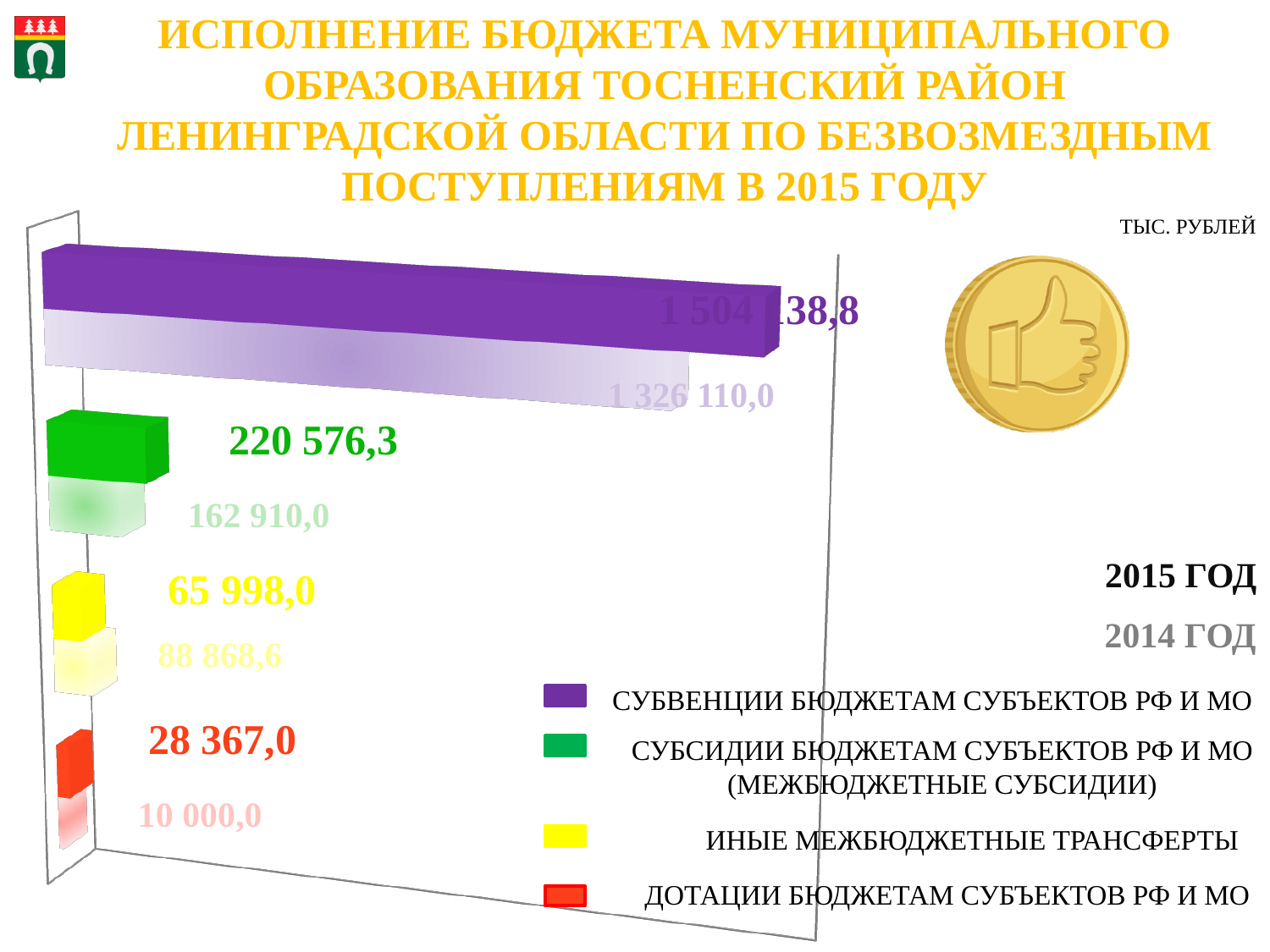
What type of chart is shown on the slide? Bar chart What was the value of иные межбюджетные трансферты in 2015? 65 998,0 What was the value of субвенции бюджетам субъектов РФ и МО in 2014? 1 326 110,0 What was the value of субсидии бюджетам субъектов РФ и МО (межбюджетные субсидии) in 2015? 220 576,3 Which category had the highest value in 2015? Субвенции бюджетам субъектов РФ и МО What was the value of дотации бюджетам субъектов РФ и МО in 2015? 28 367,0 What was the value of дотации бюджетам субъектов РФ и МО in 2014? 10 000,0 What was the value of субсидии бюджетам субъектов РФ и МО (межбюджетные субсидии) in 2014? 162 910,0 What is the difference between the 2015 and 2014 values for дотации бюджетам субъектов РФ и МО? 18 367,0 Which was larger for иные межбюджетные трансферты: the 2015 value or the 2014 value? 2014 Which category had the lowest value in 2014? Дотации бюджетам субъектов РФ и МО What was the value of иные межбюджетные трансферты in 2014? 88 868,6